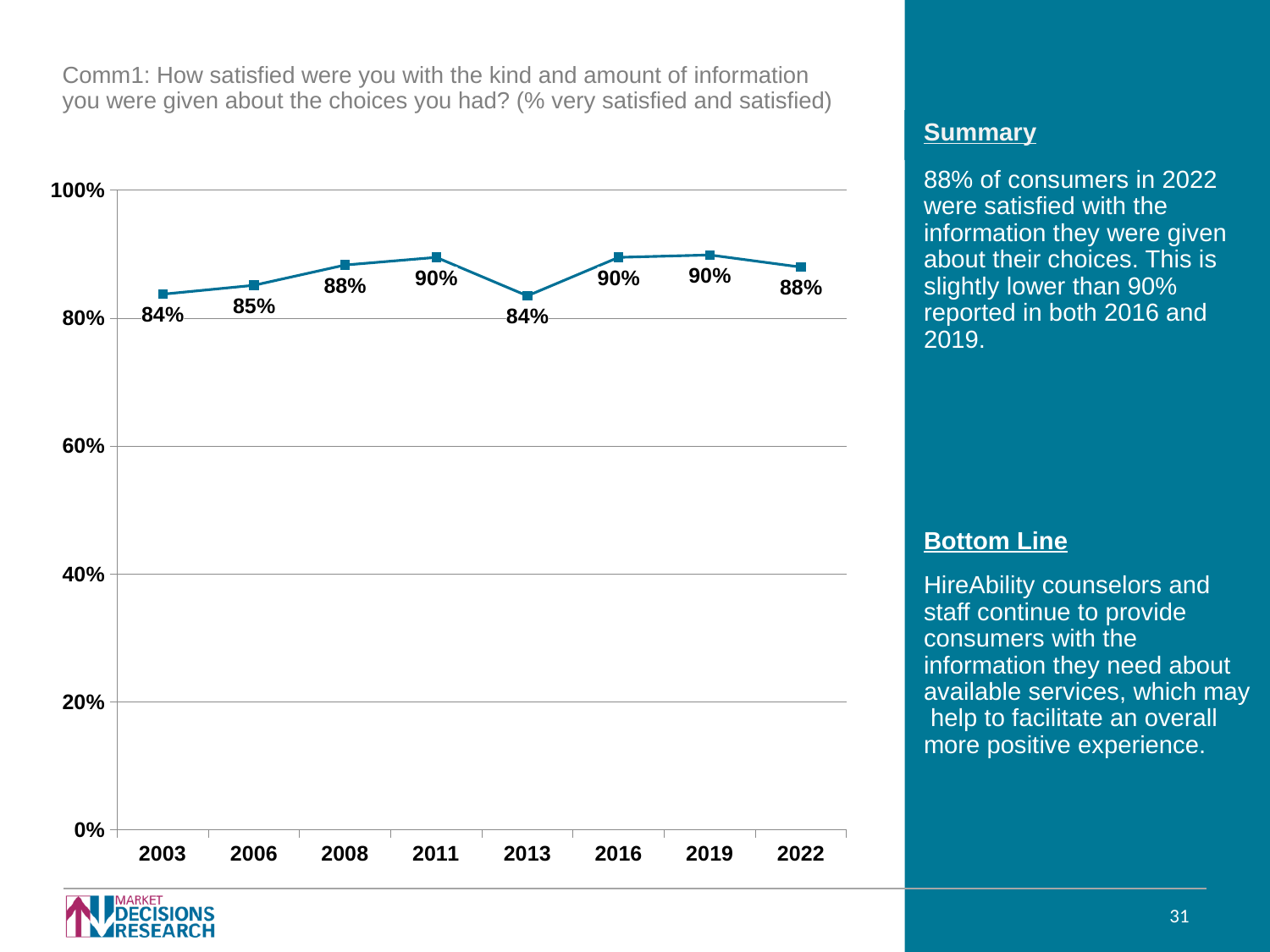
Is the value for 2013 greater or less than 80%? greater What was the satisfaction value in 2013? 84% What kind of chart is shown on the slide? line chart What was the satisfaction value in 2022? 88% How many years are plotted on the chart? 8 Did the value rise or fall from 2019 to 2022? fall What is the difference between the 2019 value and the 2022 value? 2% What was the satisfaction value in 2006? 85% What is the highest value shown on the y axis? 100% What is the difference between the 2003 value and the 2011 value? 6% Which is larger, the value for 2008 or the value for 2016? 2016 What was the satisfaction value in 2003? 84%